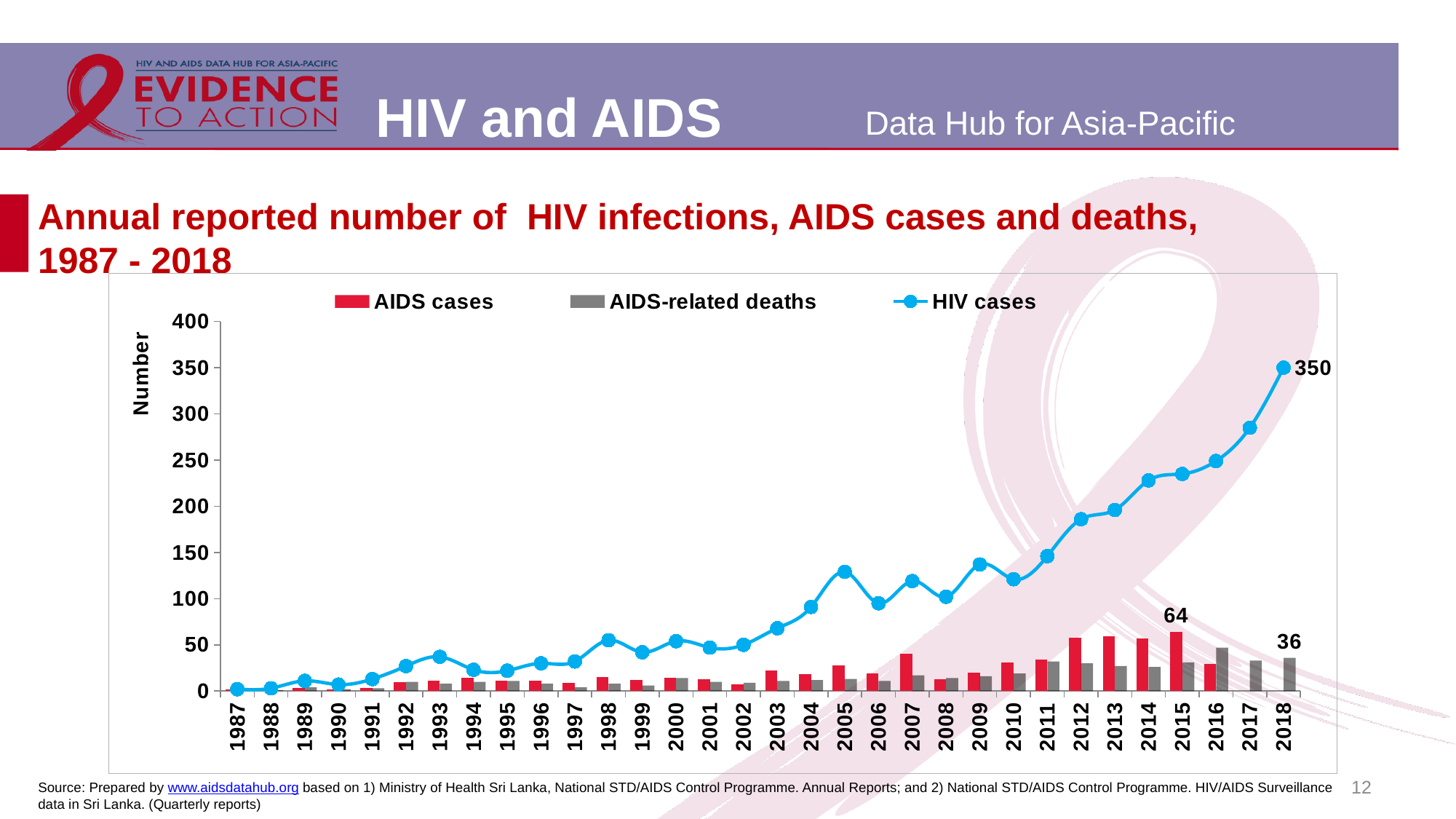
In which year is the AIDS cases bar the tallest? 2015 What is the value of HIV cases in 2018? 350 How many series does the legend list? 3 How many years are shown on the x axis? 32 Overall, do HIV cases rise or fall from 1987 to 2018? rise What is the label on the vertical axis? Number What is the value of AIDS cases in 2015? 64 In which year is the HIV cases series at its highest? 2018 Is the value of HIV cases in 2017 greater or less than 250? greater Which is larger in 2016: AIDS cases or AIDS-related deaths? AIDS-related deaths Is the value of HIV cases in 2010 greater or less than 150? less What is the value of AIDS-related deaths in 2018? 36